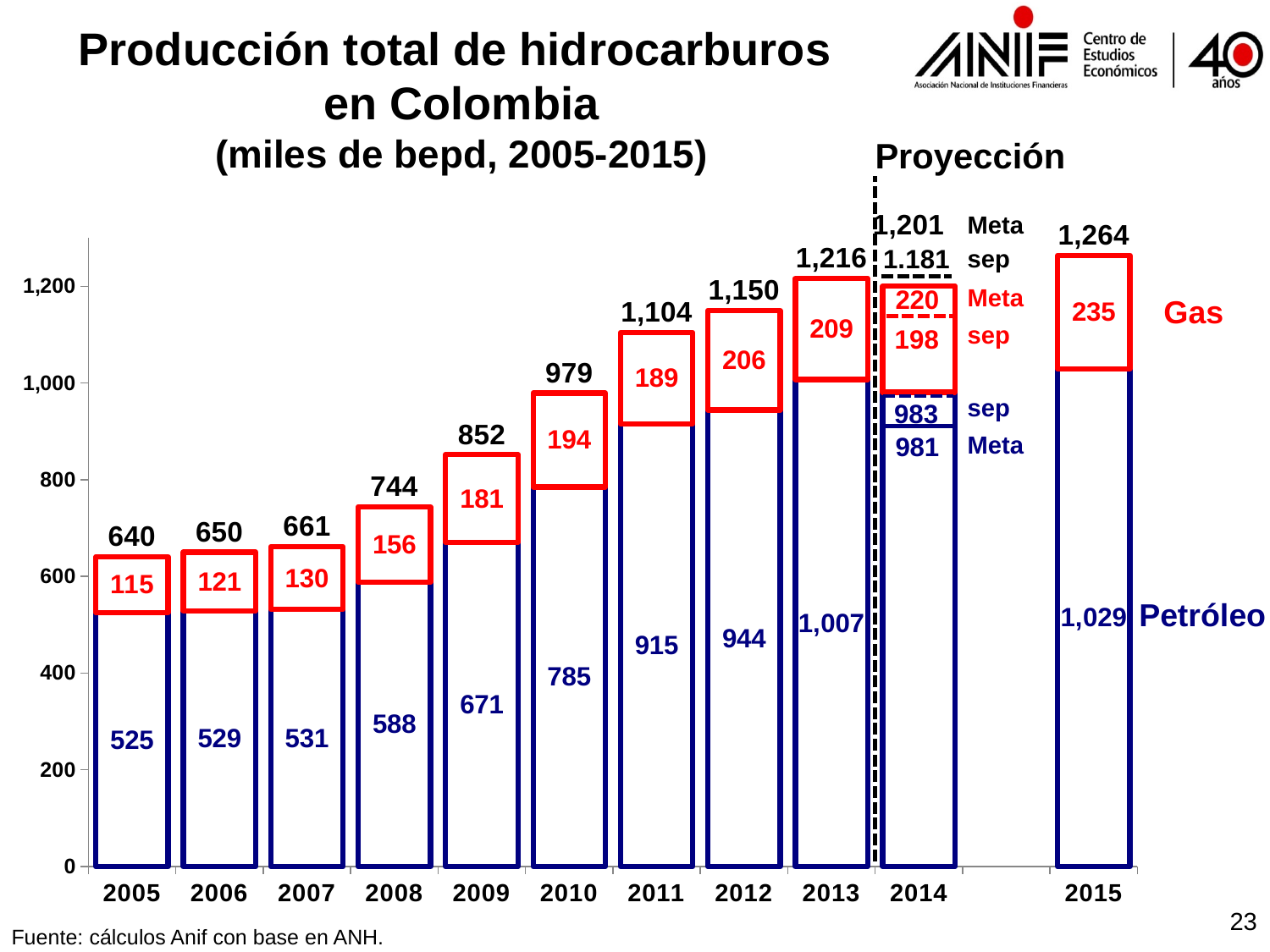
What kind of chart is shown on the slide? bar chart What is the Petróleo value for 2010? 785 Does the Petróleo value rise or fall from 2005 to 2013? rise What is the difference between the Petróleo values for 2015 and 2013? 22 How many years are shown on the x axis? 11 Which year has the highest total production? 2015 How many series does the chart show? 2 What is the total production shown for 2012? 1,150 Which year has the lowest Gas value? 2005 Which year has the larger Gas value, 2010 or 2011? 2010 What is the Gas value for 2013? 209 Is the total production for 2009 greater or less than 800? greater